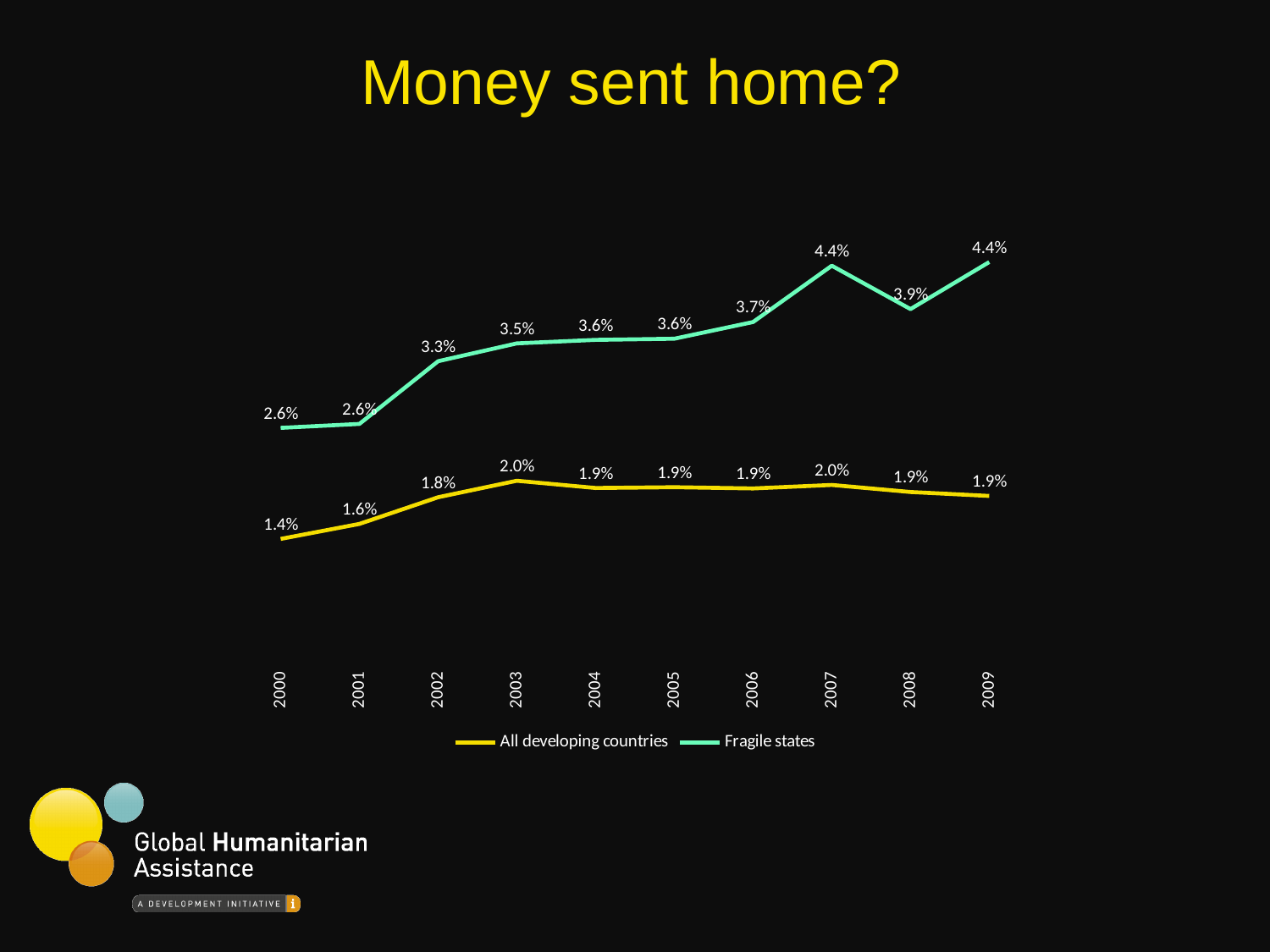
In which year is the value for All developing countries lowest? 2000 What is the difference between the Fragile states values in 2007 and 2008? 0.5% What kind of chart is shown on the slide? Line chart Which series has the larger value in 2005, All developing countries or Fragile states? Fragile states What is the value for All developing countries in 2000? 1.4% What is the value for Fragile states in 2002? 3.3% How many series does the legend list? 2 What is the difference between the Fragile states value and the All developing countries value in 2009? 2.5% What is the title of the slide? Money sent home? What is the value for All developing countries in 2003? 2.0% How many years are shown on the x axis? 10 What is the value for Fragile states in 2008? 3.9%